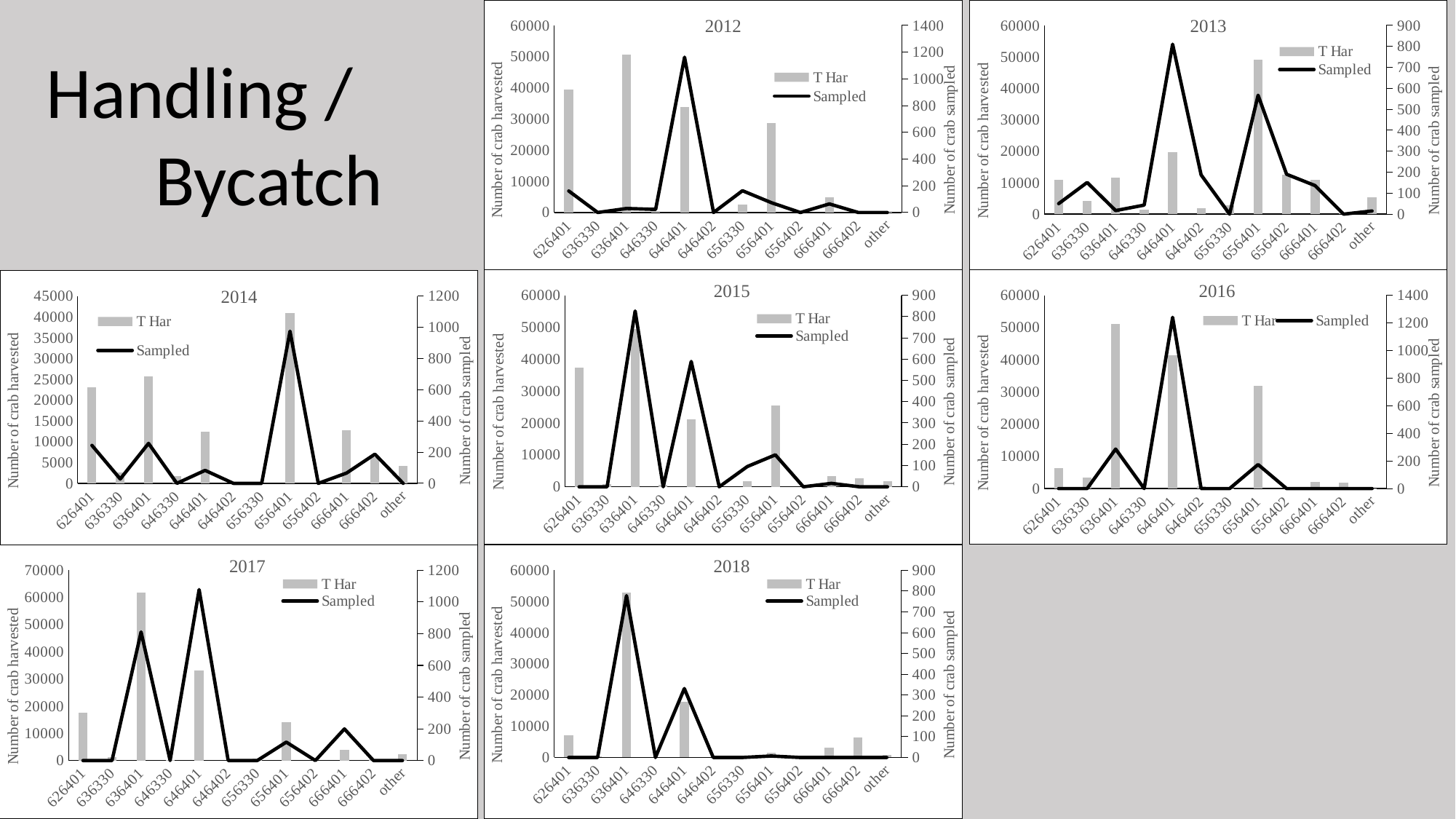
In the 2017 chart, which category has the highest T Har bar? 636401 How many series does the legend of the 2016 chart list? 2 How many charts are shown on the slide? 7 In the 2017 chart, which has the larger T Har value, 636401 or 646401? 636401 In the 2014 chart, which category has the tallest T Har bar? 656401 In the 2012 chart, is the T Har value for 626401 greater or less than 30000? greater How many categories are shown on the x axis of the 2015 chart? 12 In the 2014 chart, is the T Har value for 636401 greater or less than 20000? greater In the 2013 chart, at which category does the Sampled line reach its peak? 646401 What kind of chart is the 2018 chart? Combined bar and line chart In the 2018 chart, is the T Har value for 646401 greater or less than 20000? less